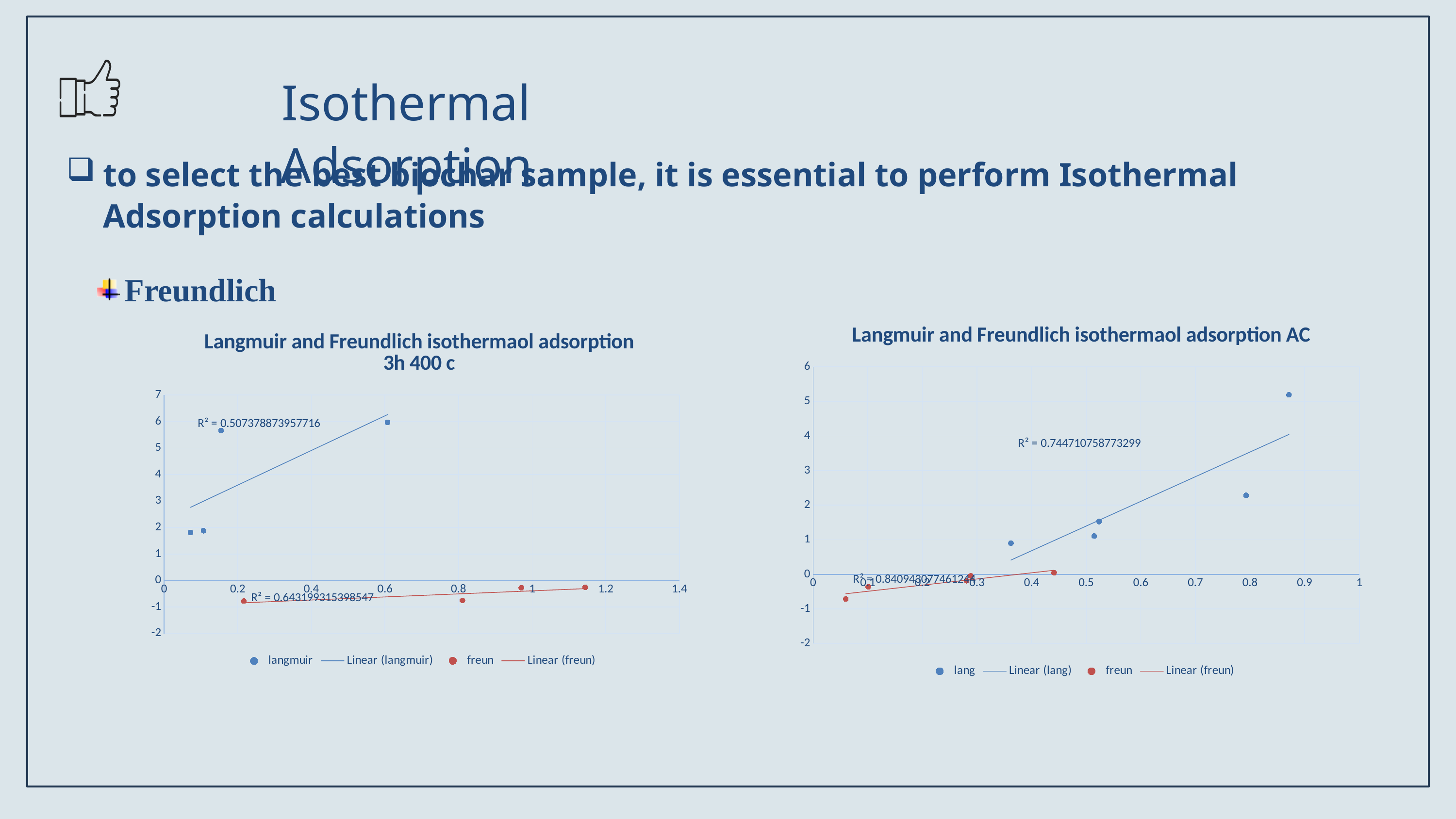
How many entries does the legend of the right chart ('Langmuir and Freundlich isothermaol adsorption AC') list? 4 What colour are the freun data points in the left chart ('3h 400 c')? red In the left chart ('3h 400 c'), is the highest langmuir data point greater or less than 5? greater How many lang data points are plotted in the right chart ('AC')? 5 In the left chart ('3h 400 c'), which trendline has the higher R² value, langmuir or freun? freun In the right chart ('AC'), what is the R² value shown for the lang trendline? R² = 0.744710758773299 In the left chart ('3h 400 c'), what is the R² value shown for the langmuir trendline? R² = 0.507378873957716 In the right chart ('AC'), do the lang values rise or fall as x increases? rise In the left chart ('3h 400 c'), what is the R² value shown for the freun trendline? R² = 0.643199315398547 In the right chart ('AC'), is the highest lang data point greater or less than 4? greater What kind of chart is the left chart titled 'Langmuir and Freundlich isothermaol adsorption 3h 400 c'? scatter chart In the left chart ('3h 400 c'), are the freun data points greater or less than 0? less